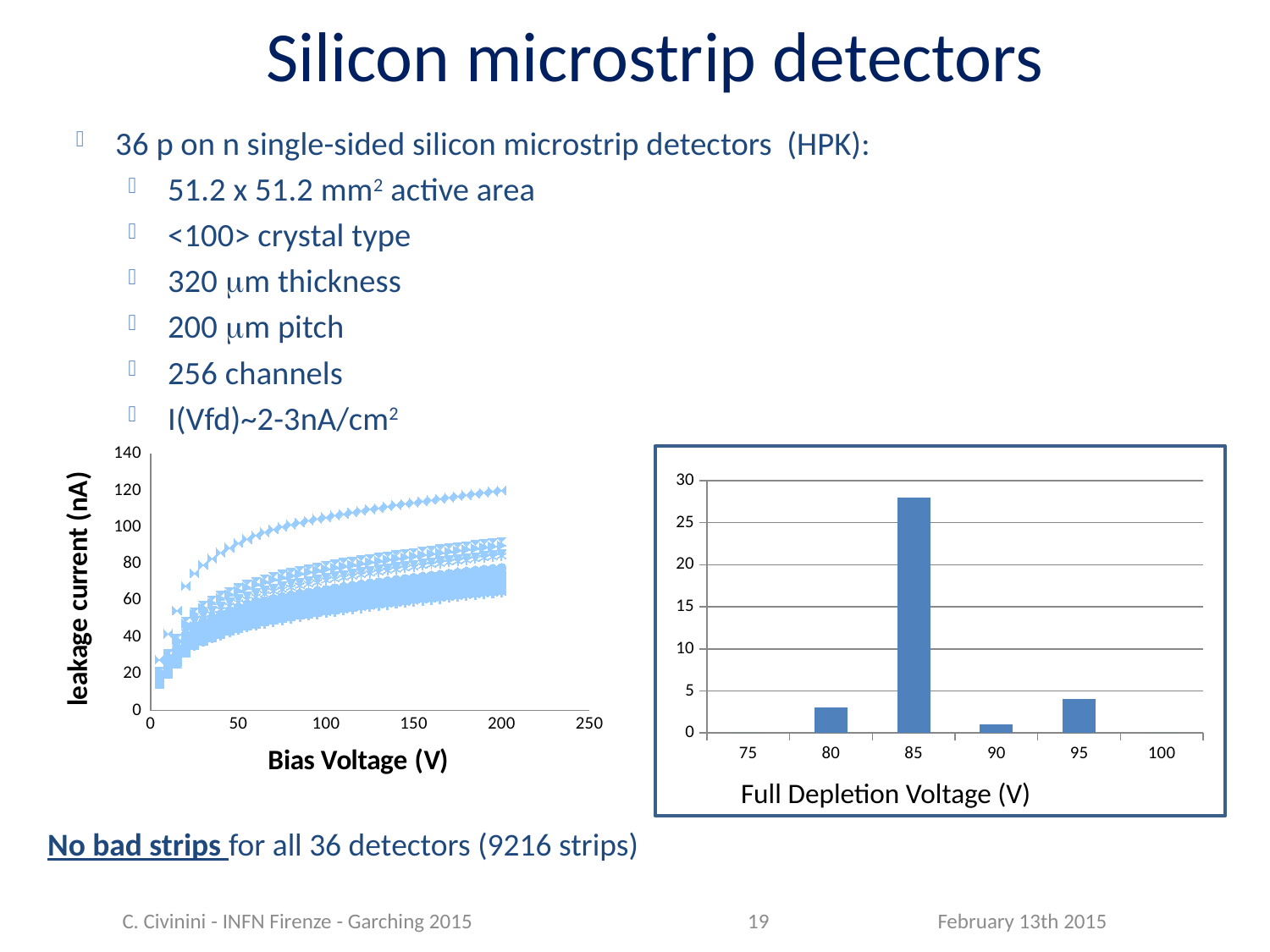
In the Full Depletion Voltage chart on the right, which is larger, the value for 85 or the value for 95? 85 In the Full Depletion Voltage chart on the right, is the value for 85 greater or less than 25? greater What is the y-axis title of the chart on the left of the slide? leakage current (nA) In the leakage current chart on the left, does the leakage current rise or fall as the bias voltage increases? rise In the Full Depletion Voltage chart on the right, is the value for 95 greater or less than 5? less In the Full Depletion Voltage chart on the right, which is larger, the value for 95 or the value for 90? 95 In the Full Depletion Voltage chart on the right, which voltage category has the tallest bar? 85 What is the x-axis title of the chart on the right of the slide? Full Depletion Voltage (V) In the leakage current chart on the left, is the highest leakage current at 200 V greater or less than 100? greater How many voltage categories are shown on the x axis of the Full Depletion Voltage chart on the right? 6 What type of chart is the chart on the right of the slide (Full Depletion Voltage)? bar chart